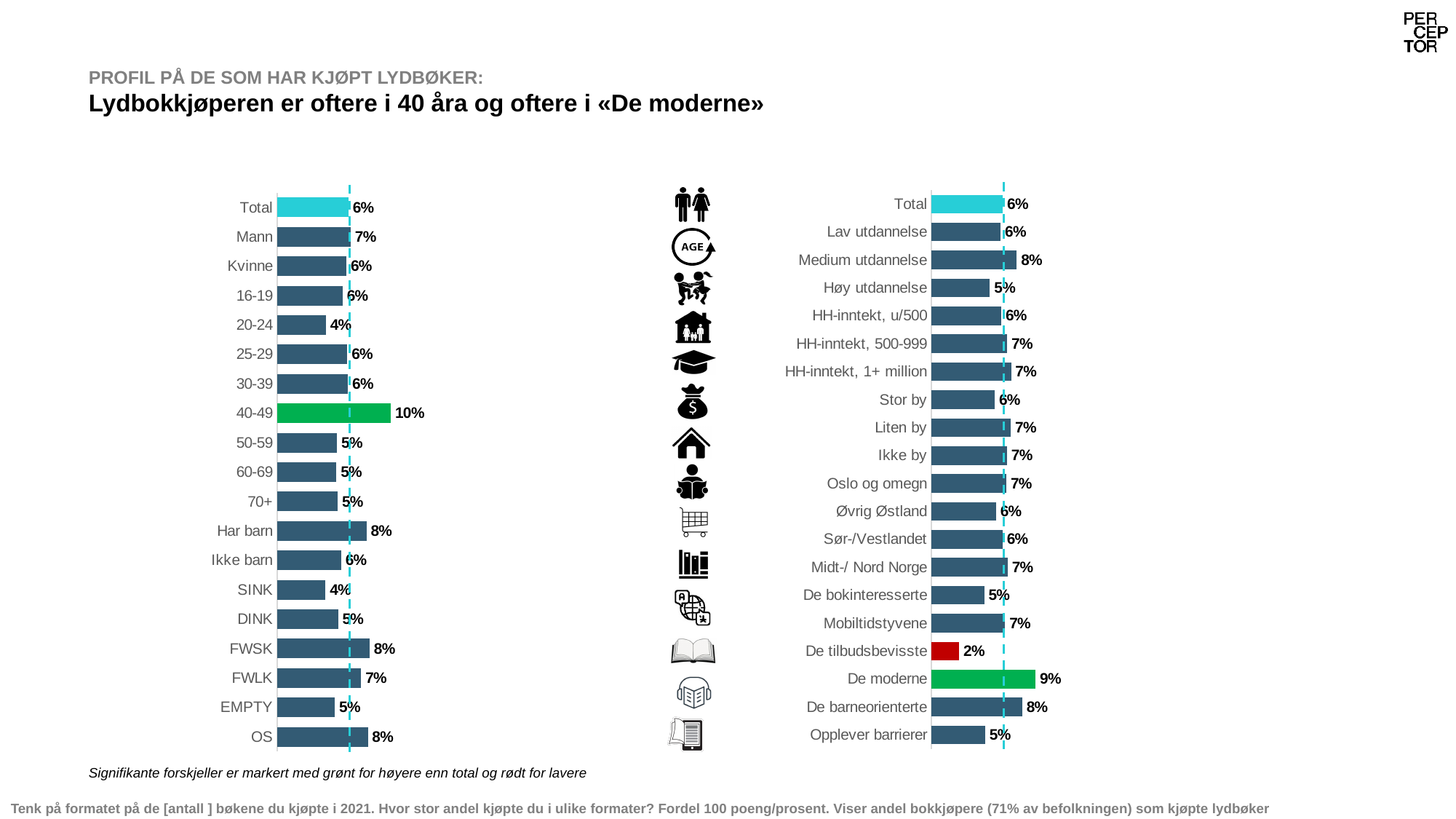
In the left chart, what is the value for 40-49? 10% In the left chart, which category has the highest value? 40-49 How many categories are shown in the right chart? 20 What type of chart is the left chart? Bar chart In the right chart, which category has the highest value? De moderne In the left chart, what is the value for SINK? 4% In the left chart, which is larger, the value for Har barn or the value for Ikke barn? Har barn In the right chart, what is the value for Medium utdannelse? 8% In the left chart, what is the difference between the values for 40-49 and 20-24? 6% In the right chart, which category has the lowest value? De tilbudsbevisste In the right chart, what is the value for De tilbudsbevisste? 2% In the right chart, what is the difference between the values for De moderne and De tilbudsbevisste? 7%